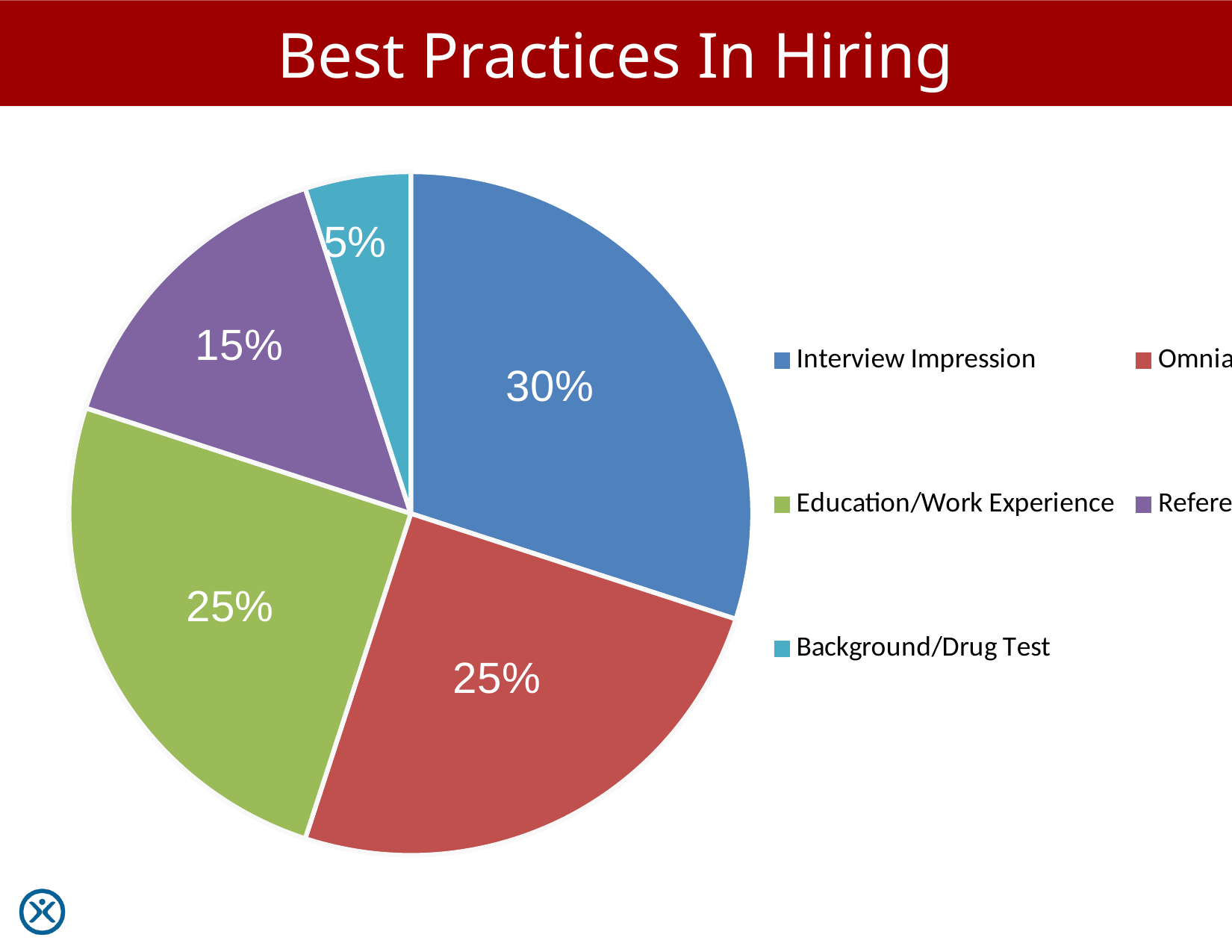
How many percentage points larger is Interview Impression than Background/Drug Test? 25 percentage points Which category has the largest slice of the pie? Interview Impression What percentage does the Background/Drug Test slice show? 5% How many slices does the pie chart have? 5 How many percentage points larger is Education/Work Experience than Background/Drug Test? 20 percentage points What kind of chart is shown on the slide? pie chart What colour is the Interview Impression slice? blue Which category has the smallest slice of the pie? Background/Drug Test What percentage does the Interview Impression slice show? 30% Which is larger, Interview Impression or Education/Work Experience? Interview Impression What percentage does the Education/Work Experience slice show? 25% What is the title of the slide containing the pie chart? Best Practices In Hiring